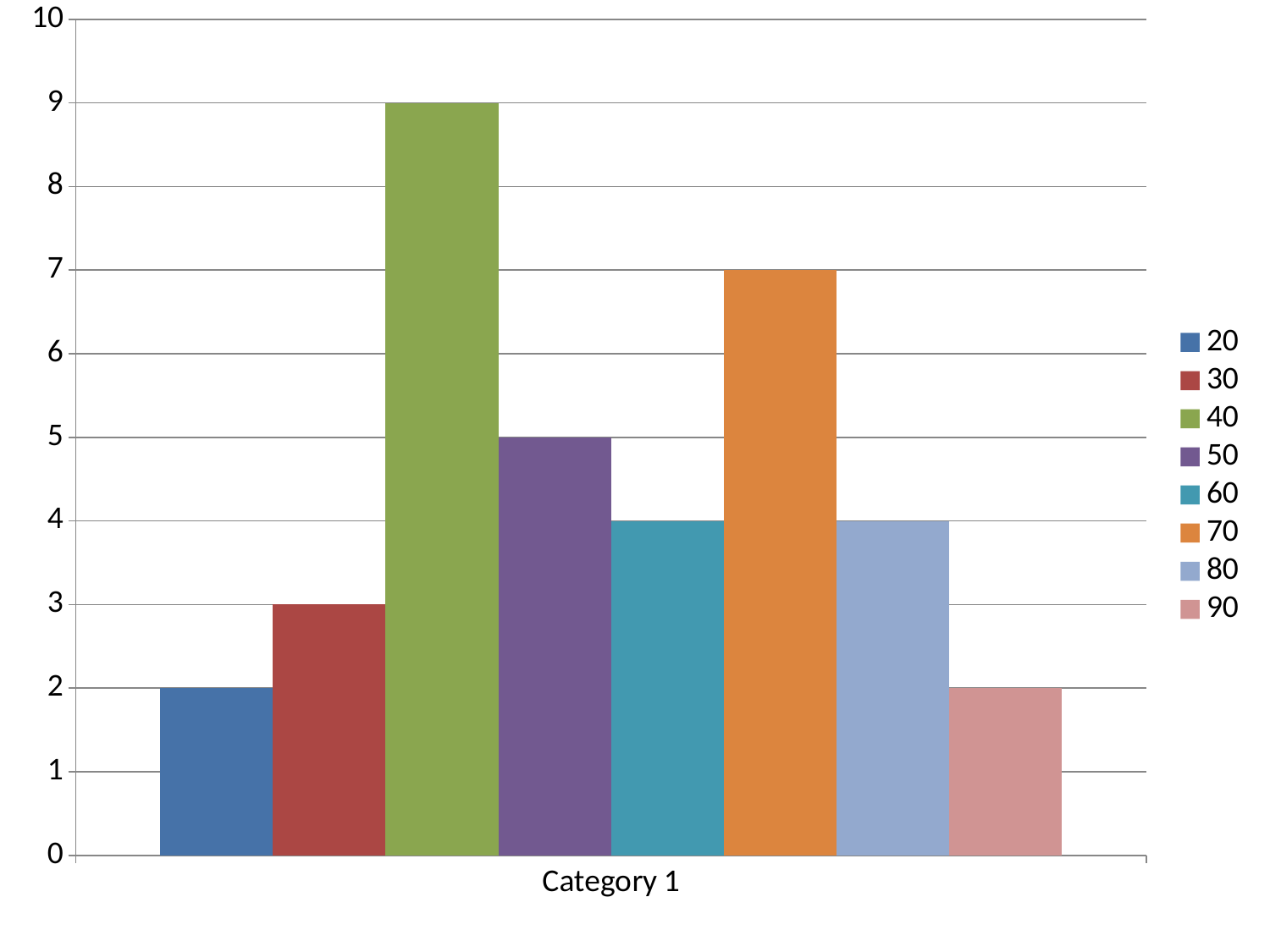
What kind of chart is shown on the slide? bar chart Which series has the highest value for Category 1? 40 Which series has the lowest value for Category 1, the series "20" or the series "30"? 20 What is the value of the series "50" for Category 1? 5 How many categories are shown on the x axis? 1 How many series does the legend list? 8 What is the value of the series "70" for Category 1? 7 Is the value for the series "30" greater or less than 5? less What is the value of the series "40" for Category 1? 9 What is the label of the category on the x axis? Category 1 What is the difference between the values of the series "40" and the series "70"? 2 Which is larger, the value of the series "50" or the value of the series "60"? 50